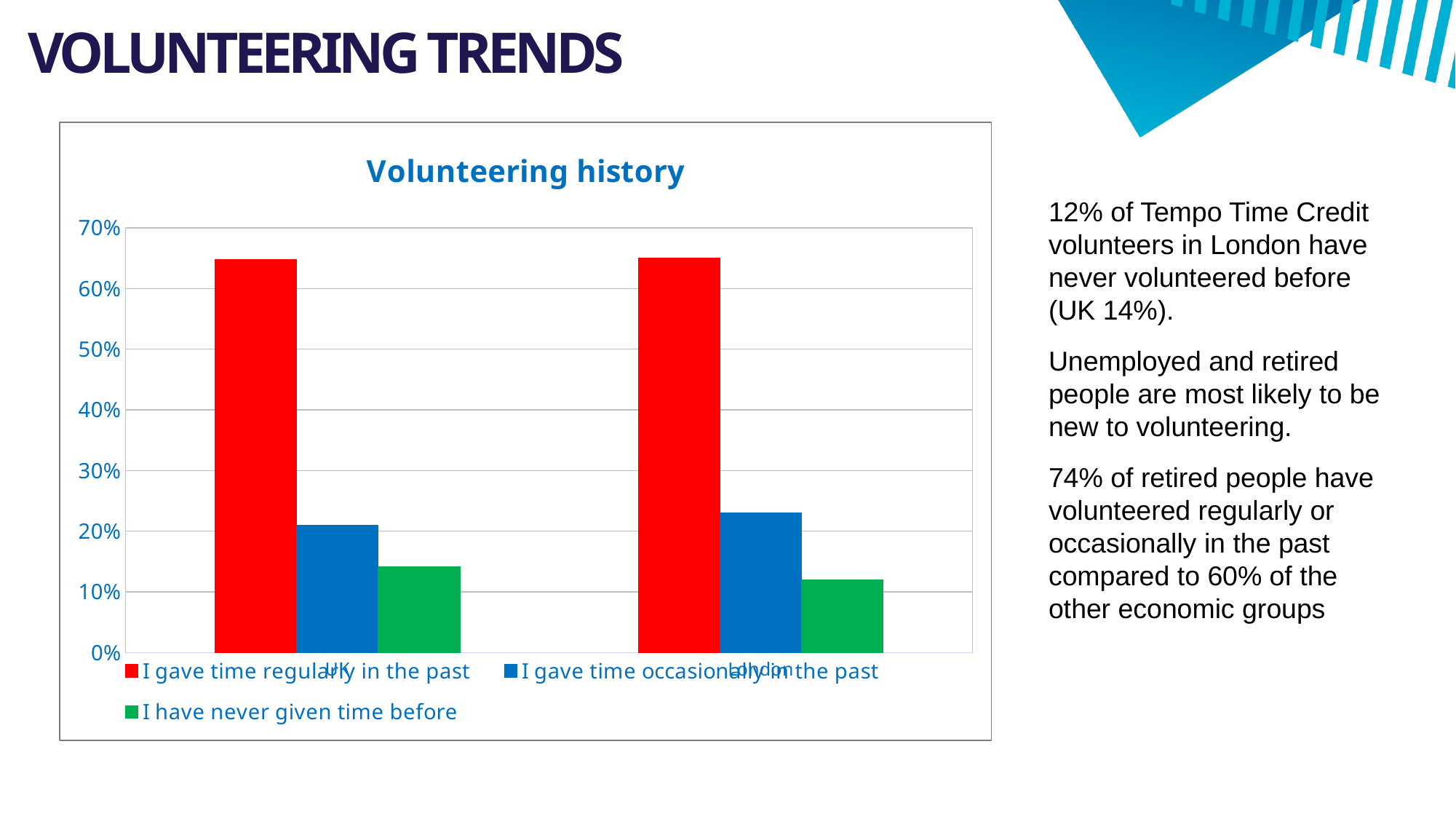
What colour represents the series 'I have never given time before'? Green What is the title of the chart? Volunteering history How many category groups of bars are plotted on the chart? 2 Which series has the tallest bar in the UK group? I gave time regularly in the past In the UK group, which is larger: 'I gave time occasionally in the past' or 'I have never given time before'? I gave time occasionally in the past What kind of chart is shown on the slide? Bar chart Is the value for 'I gave time regularly in the past' in the UK group greater or less than 60%? greater Which series has the shortest bar in the UK group? I have never given time before Is the value for 'I have never given time before' in the UK group greater or less than 20%? less Is the value for 'I gave time regularly in the past' in the right-hand category group greater or less than 60%? greater How many series does the chart's legend list? 3